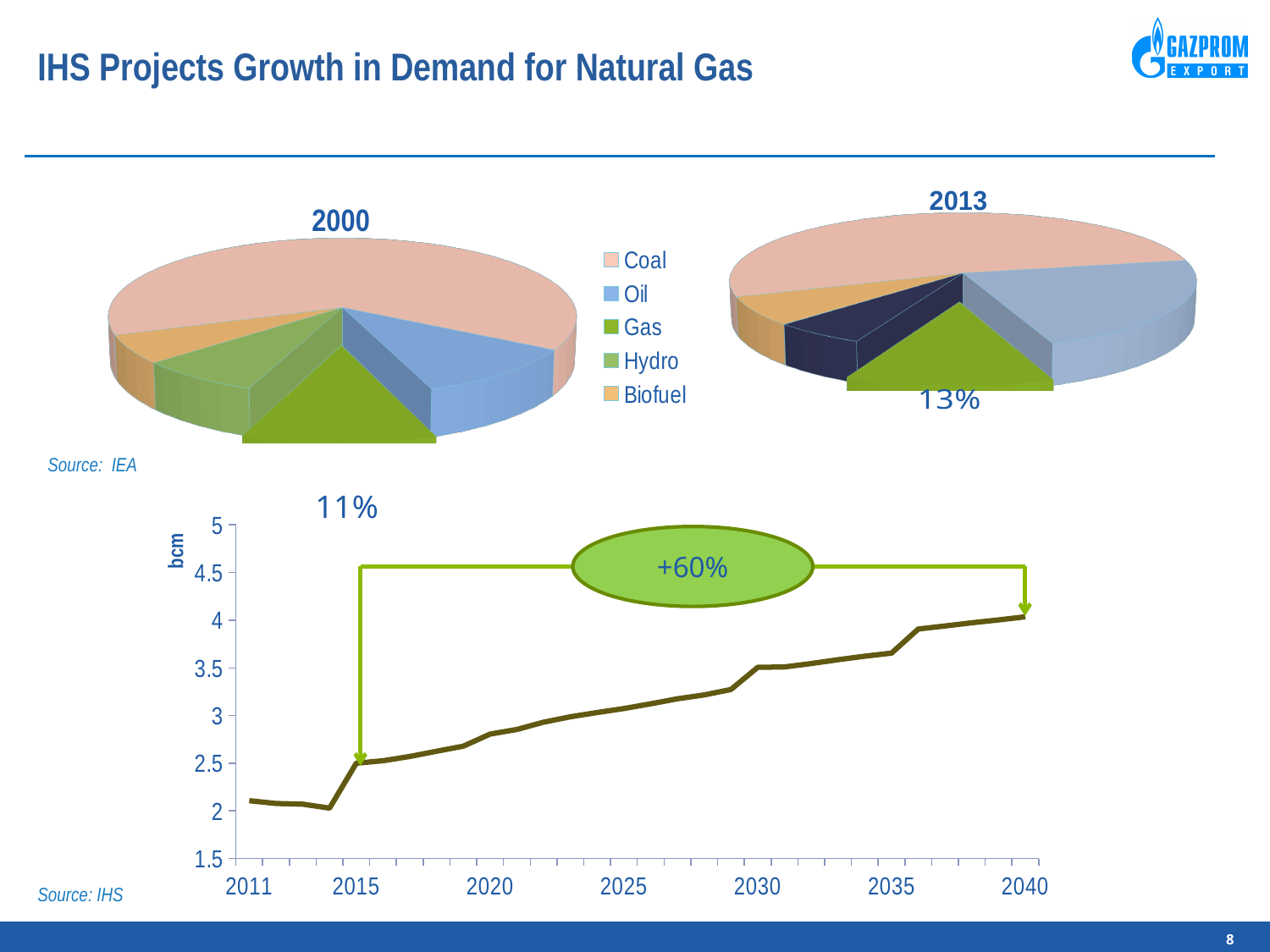
In the bottom line chart, do the values generally rise or fall from 2011 to 2040? Rise In the bottom line chart, is the value for 2011 greater or less than 2.5? less In the bottom line chart, is the value for 2040 greater or less than 3.5? greater In the 2000 pie chart, what share is labelled for the Gas slice? 11% In the 2000 pie chart, which category has the largest slice? Coal In the 2013 pie chart, what share is labelled for the Gas slice? 13% In the bottom line chart, what unit is shown on the vertical axis? bcm What kind of chart is the bottom chart with the bcm axis? Line chart In the 2013 pie chart, which category has the largest slice? Coal How many entries does the legend shared by the two pie charts list? 5 Comparing the 2000 and 2013 pie charts, by how many percentage points did the labelled Gas share change? 2 percentage points Comparing the 2000 and 2013 pie charts, which year shows the larger Gas share? 2013